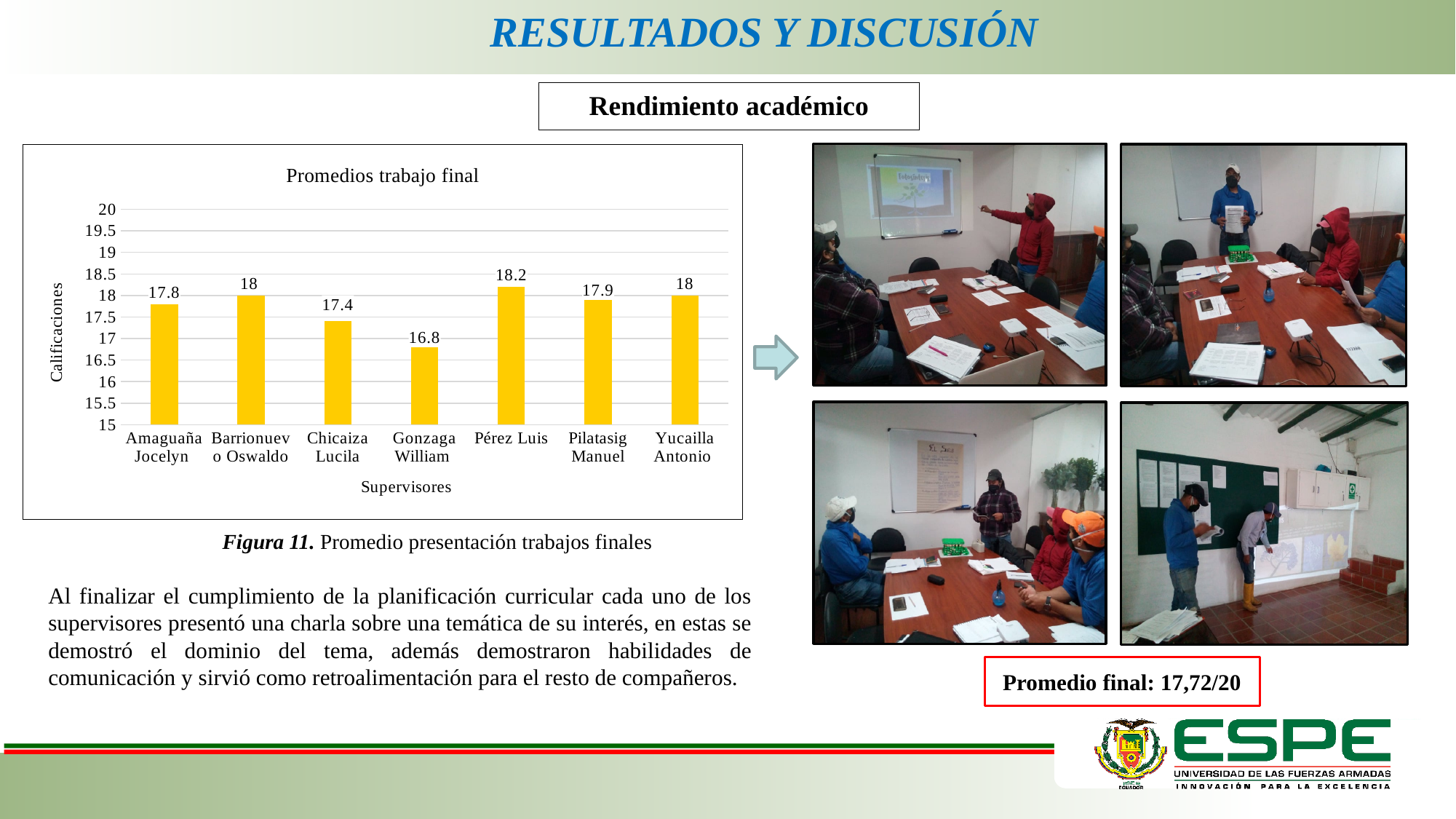
Which supervisor has the lowest value in the chart? Gonzaga William What is the label of the vertical axis of the chart? Calificaciones Which supervisor has the highest value in the chart? Pérez Luis What is the value for Pilatasig Manuel in the chart? 17.9 What is the value for Gonzaga William in the chart? 16.8 What is the difference between the values for Pérez Luis and Gonzaga William? 1.4 What kind of chart is shown on the slide? bar chart What is the title of the chart? Promedios trabajo final Which is larger, the value for Chicaiza Lucila or the value for Yucailla Antonio? Yucailla Antonio Is the value for Gonzaga William greater or less than 17? less How many supervisors are shown in the chart? 7 What is the value for Amaguaña Jocelyn in the chart? 17.8